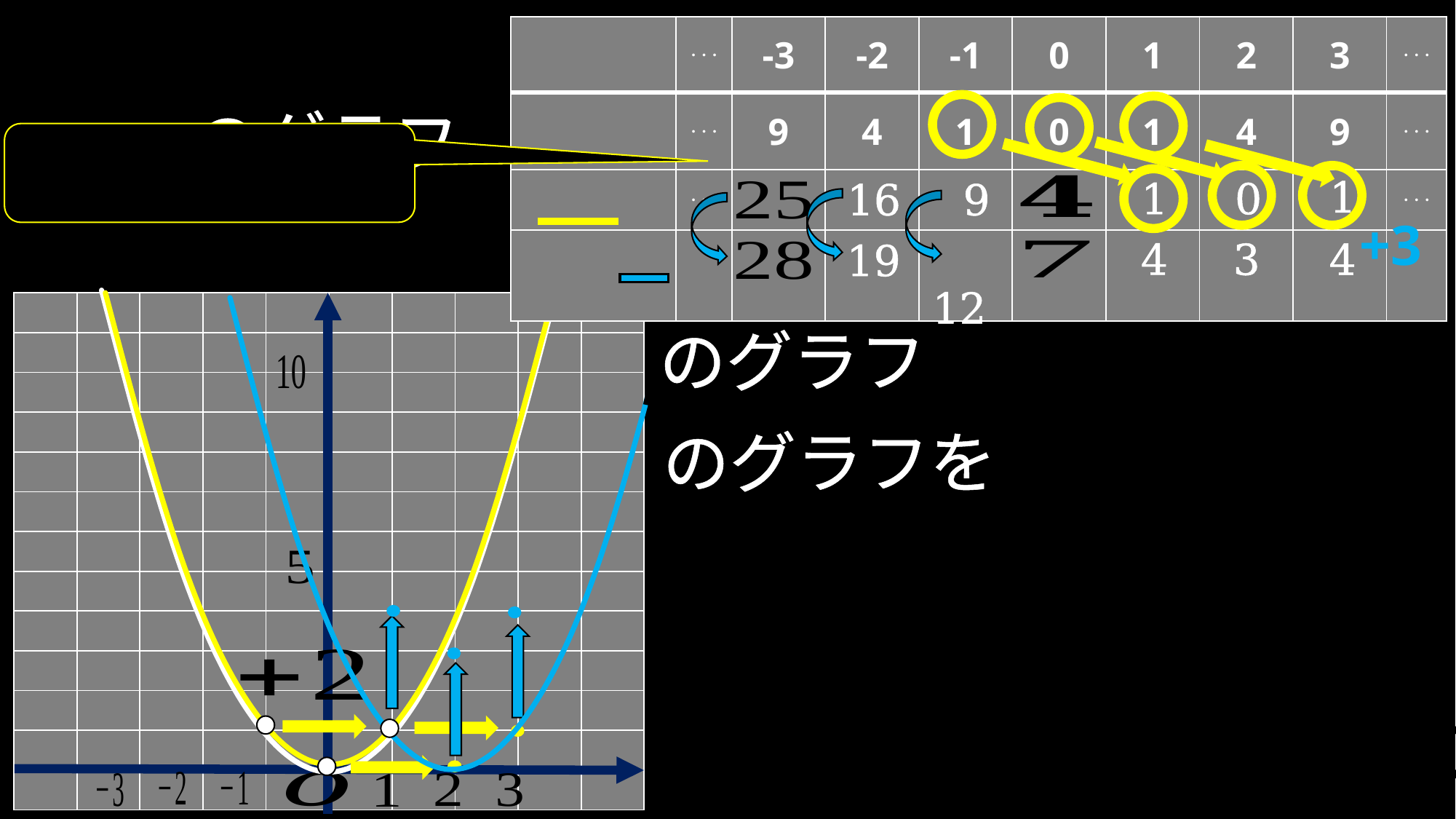
What colour is the parabola whose vertex is at the origin O? white Is the plot in the lower left a bar chart or a graph of curves? a graph of curves At which x value does the blue parabola touch the x-axis? 2 What is the largest tick label shown on the vertical axis of the graph? 10 How many parabolas are drawn on the coordinate graph? 3 What label is written next to the yellow horizontal arrows on the graph? +2 Which tick labels are printed on the vertical axis of the graph? 5 and 10 What is the smallest x-axis label shown on the graph? -3 What is the largest x-axis label shown on the graph? 3